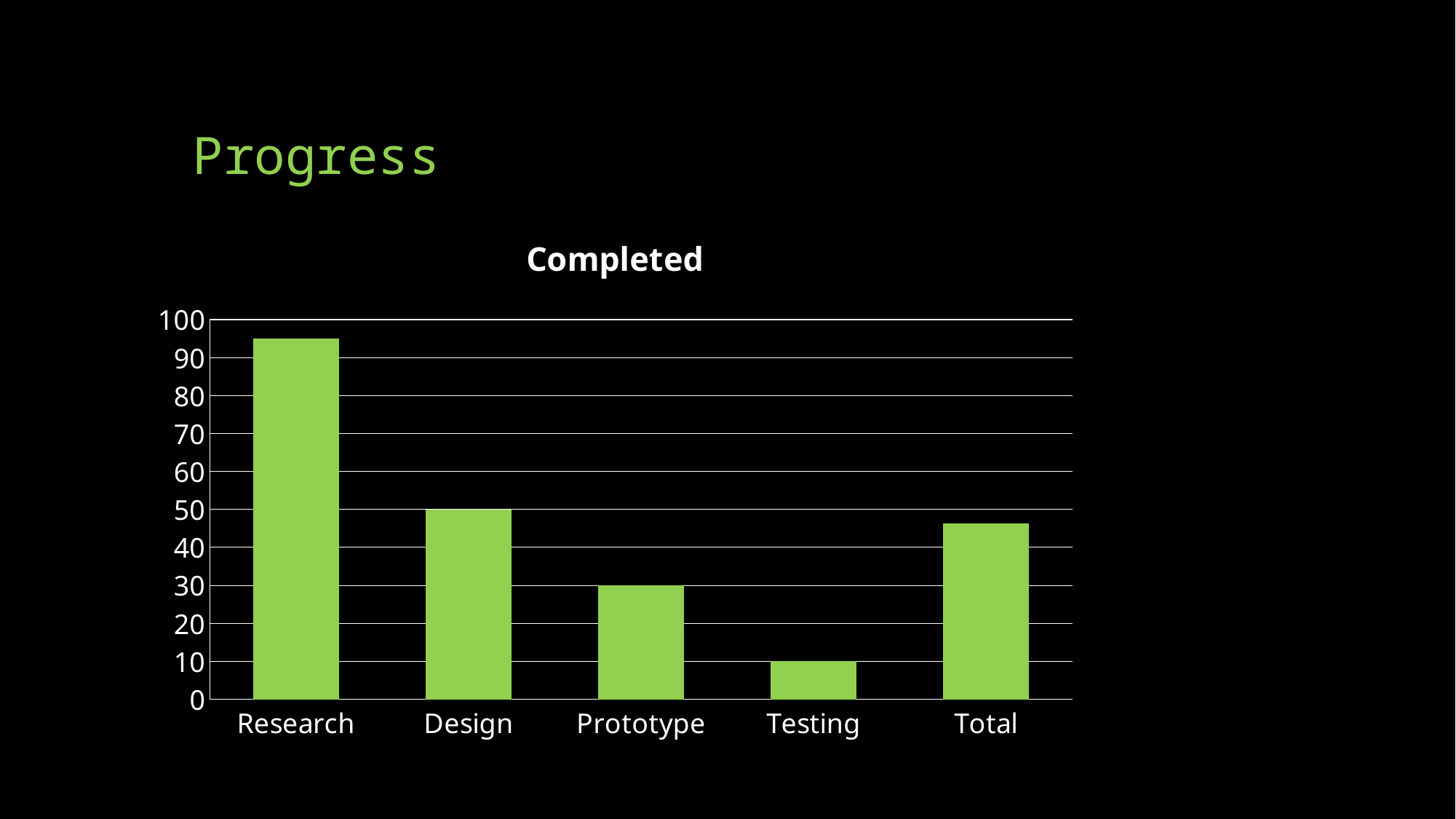
What is the title of the chart? Completed How many categories are shown on the x axis? 5 What is the difference between the values for Design and Prototype? 20 What is the value for Prototype? 30 Which category has the lowest value? Testing What is the difference between the values for Design and Testing? 40 Is the value for Research greater or less than 90? greater Which category has the highest value? Research What is the value for Testing? 10 Which is larger, the value for Research or the value for Total? Research Is the value for Total greater or less than 50? less What is the value for Design? 50